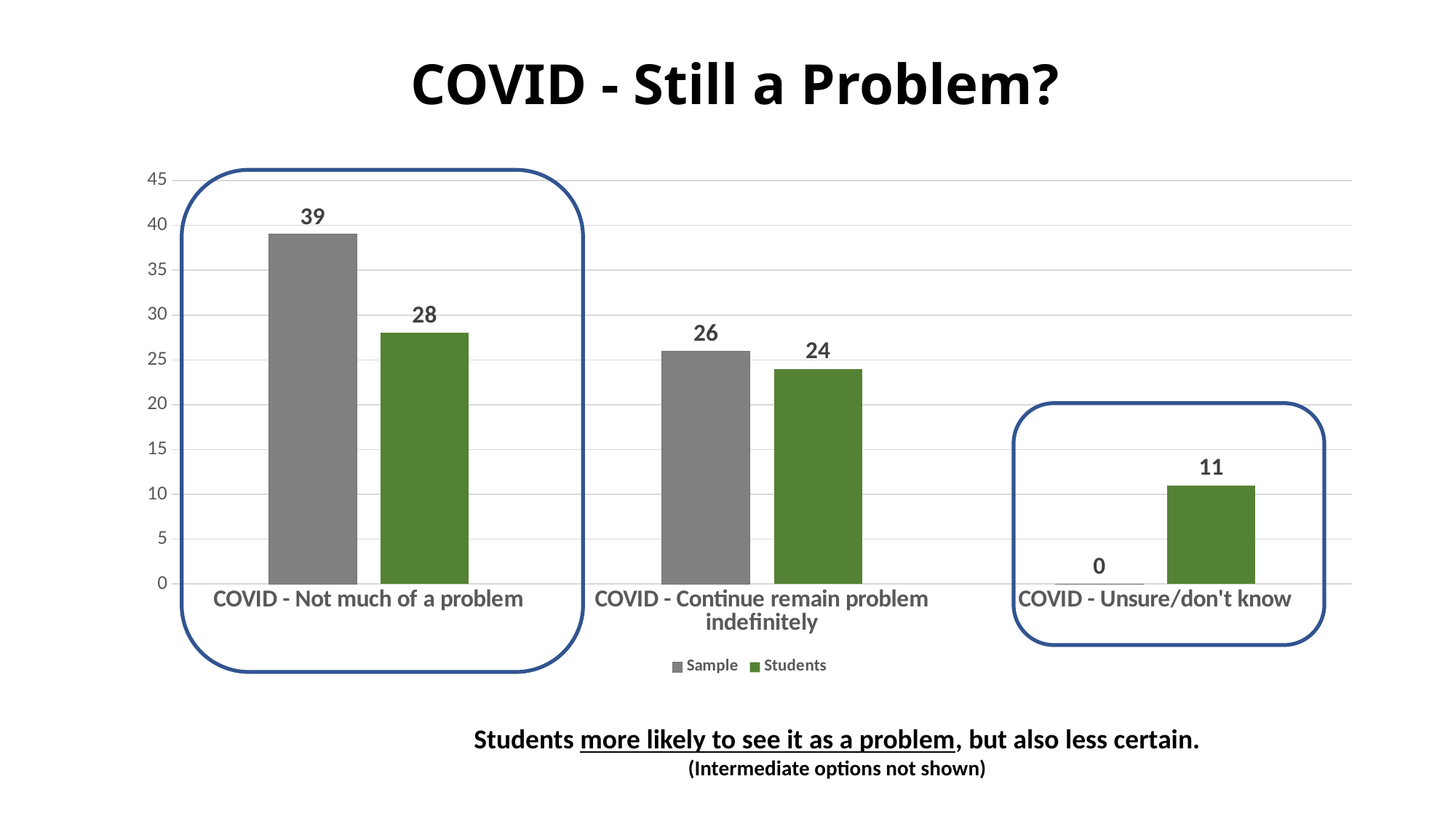
Which is larger for "COVID - Continue remain problem indefinitely": the Sample value or the Students value? Sample What is the Sample value for "COVID - Not much of a problem"? 39 What is the difference between the Sample and Students values for "COVID - Not much of a problem"? 11 How many series does the legend list? 2 What is the Sample value for "COVID - Unsure/don't know"? 0 What is the Students value for "COVID - Unsure/don't know"? 11 What is the Students value for "COVID - Continue remain problem indefinitely"? 24 What is the title of the slide? COVID - Still a Problem? How many categories are shown on the x axis? 3 Which category has the highest Sample value? COVID - Not much of a problem What kind of chart is shown on the slide? Bar chart Which category has the lowest Students value? COVID - Unsure/don't know